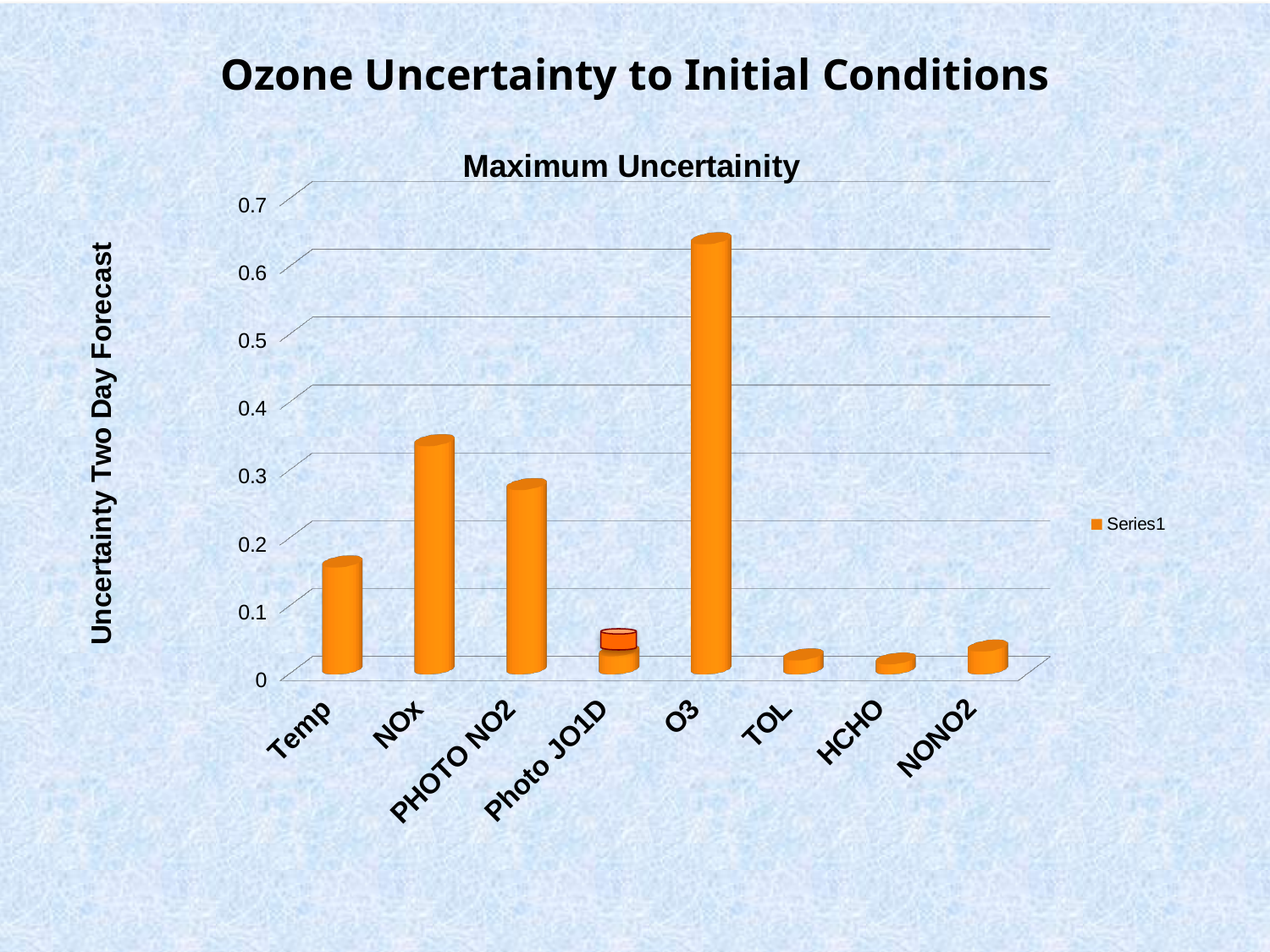
How many categories are plotted on the x axis of the chart? 8 Which has a larger value, PHOTO NO2 or Photo JO1D? PHOTO NO2 How many series does the legend list? 1 What is the label on the vertical axis of the chart? Uncertainty Two Day Forecast Is the value for O3 greater or less than 0.5? greater Is the value for Photo JO1D greater or less than 0.1? less Which category has the highest value in the chart? O3 Which has a larger value, NOx or Temp? NOx What type of chart is shown on the slide? Bar chart Is the value for Temp greater or less than 0.2? less What is the title of the chart? Maximum Uncertainity